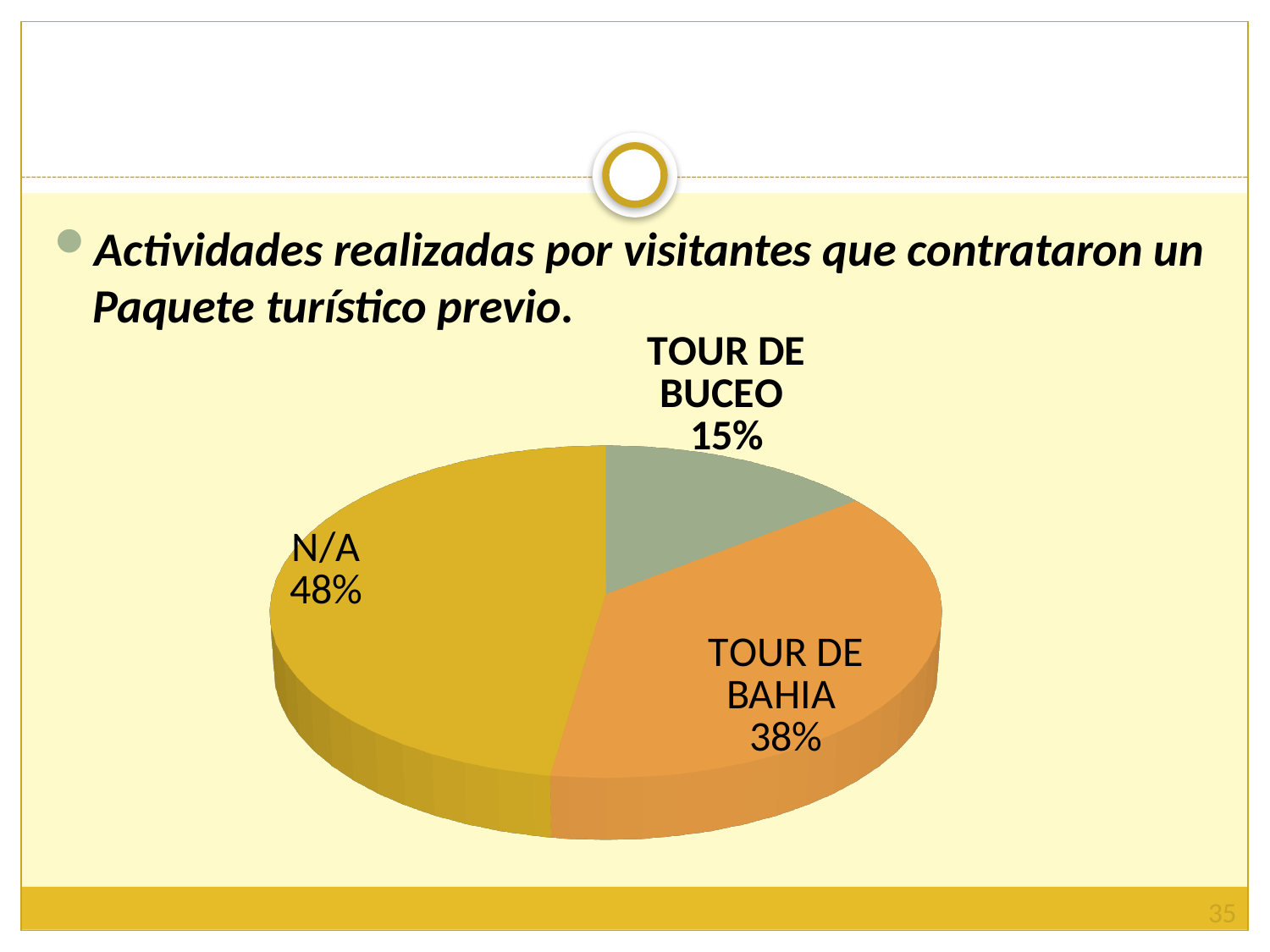
Which is larger, the share for TOUR DE BAHIA or the share for TOUR DE BUCEO? TOUR DE BAHIA What is the difference in percentage points between TOUR DE BAHIA and TOUR DE BUCEO? 23 What share of the pie does N/A represent? 48% What is the difference in percentage points between N/A and TOUR DE BAHIA? 10 What colour is the TOUR DE BUCEO slice of the pie? grey-green What share of the pie does TOUR DE BUCEO represent? 15% Which slice of the pie is the largest? N/A What colour is the N/A slice of the pie? gold/yellow What share of the pie does TOUR DE BAHIA represent? 38% What kind of chart is shown on the slide? pie chart How many slices does the pie chart have? 3 Which slice of the pie is the smallest? TOUR DE BUCEO